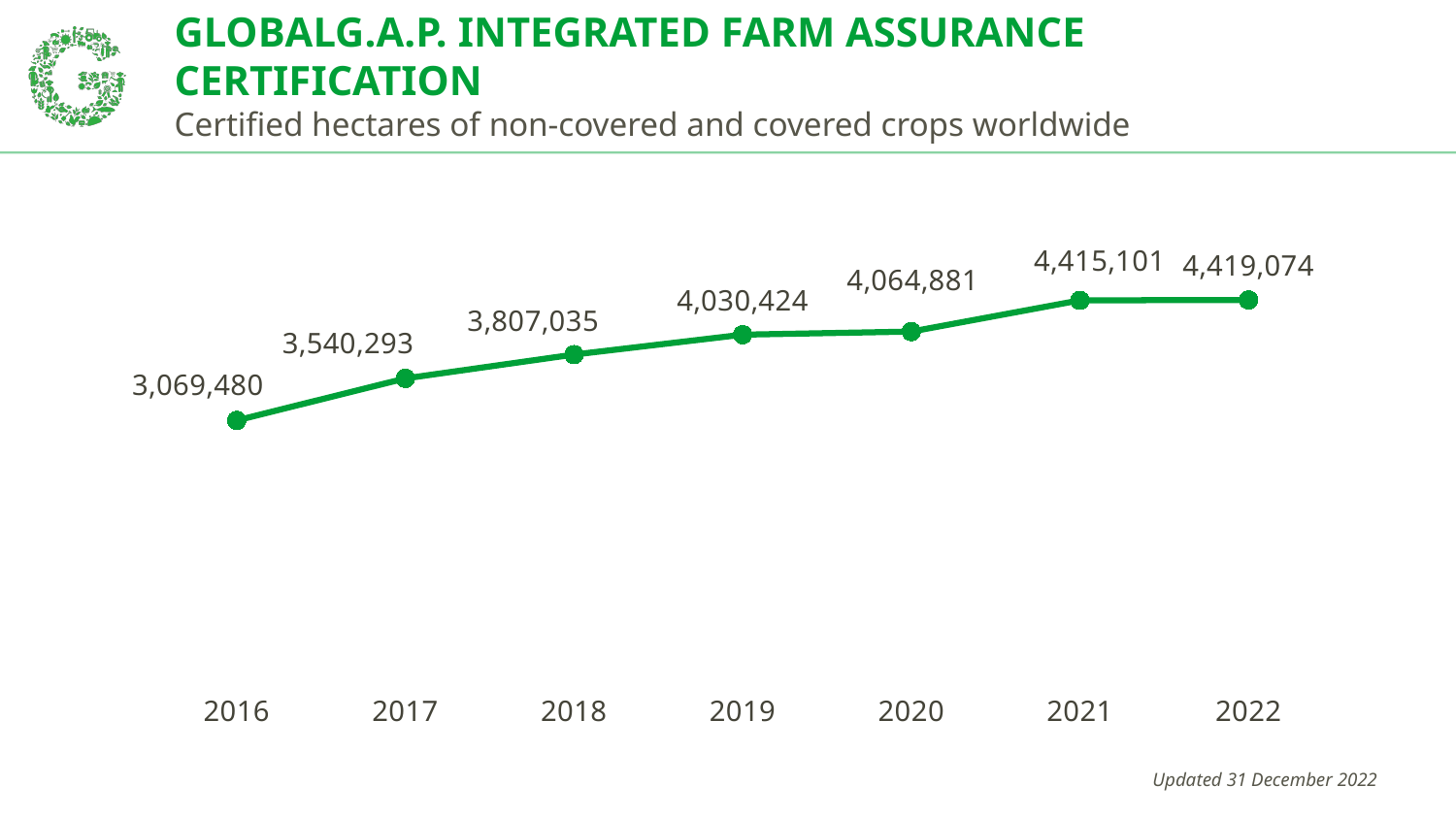
What kind of chart is shown on the slide? Line chart Which year has more certified hectares, 2018 or 2020? 2020 How many years are plotted on the chart? 7 What is the difference in certified hectares between 2017 and 2016? 470,813 What is the number of certified hectares in 2019? 4,030,424 What is the number of certified hectares in 2016? 3,069,480 What colour is the line on the chart? Green What is the number of certified hectares in 2022? 4,419,074 Which year has the highest number of certified hectares? 2022 Do the certified hectares rise or fall from 2016 to 2022? Rise Which year has the lowest number of certified hectares? 2016 What is the difference in certified hectares between 2022 and 2021? 3,973